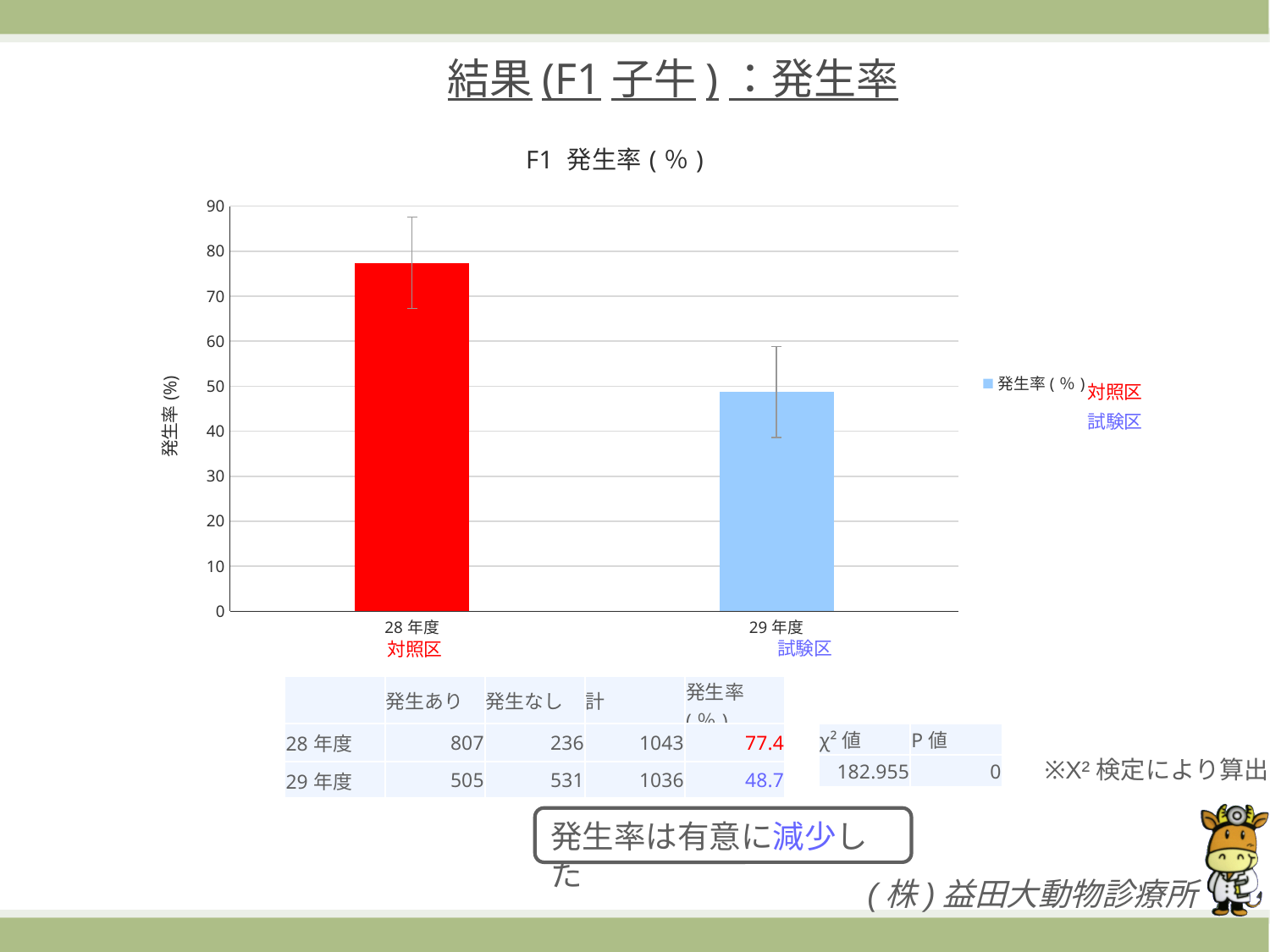
What is the 発生率(%) for 28年度 as printed on the slide? 77.4 How many series does the chart legend list? 1 How many bars (categories) are plotted in the chart? 2 Is the value for 28年度 greater or less than 70? greater Which category has the lower 発生率 in the chart? 29年度 Which category has the higher 発生率 in the chart? 28年度 What is the 発生率(%) for 29年度 as printed on the slide? 48.7 Is the value for 29年度 greater or less than 50? less What is the title of the chart? F1 発生率(%) What is the label on the vertical axis of the chart? 発生率(%) Does the 発生率 rise or fall from 28年度 to 29年度? fall What type of chart is shown on the slide? bar chart